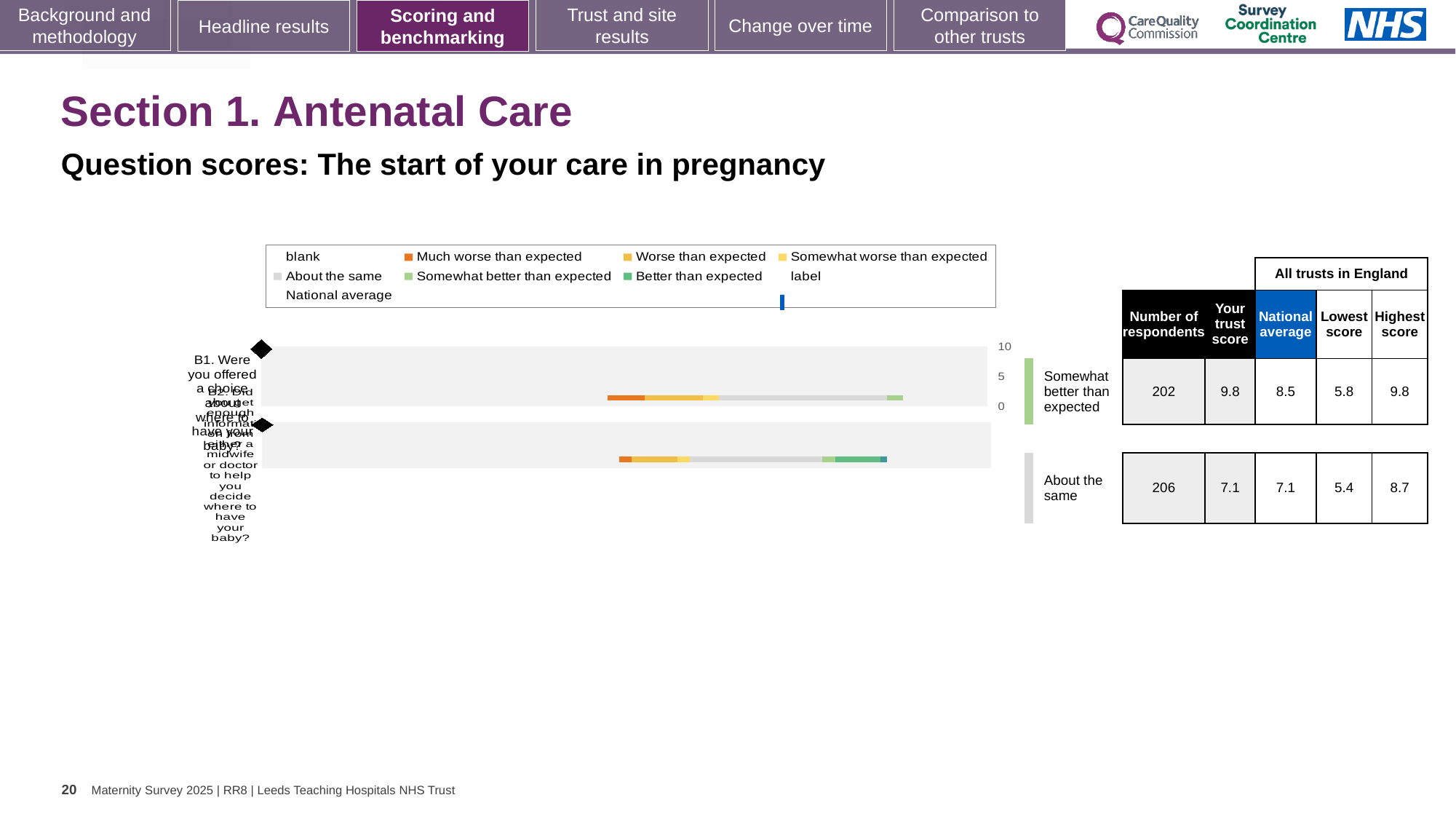
In the chart legend, what does the blue marker represent? National average What kind of chart is shown on the slide? bar chart Which question, B1 or B2, has the higher trust score? B1 For question B1, what is the difference between the trust score and the national average? 1.3 In the table beside the chart, what is the highest score across all trusts in England for question B2? 8.7 How many survey questions (B1, B2) are plotted as bars in the chart? 2 In the table beside the chart, how many respondents are listed for question B1? 202 In the table beside the chart, what is the lowest score across all trusts in England for question B1? 5.8 What is the highest tick value shown on the chart's score axis? 10 For question B1, which is larger: the trust score or the national average? the trust score In the table beside the chart, what is the national average for question B2? 7.1 In the table beside the chart, what is the trust score for question B1? 9.8